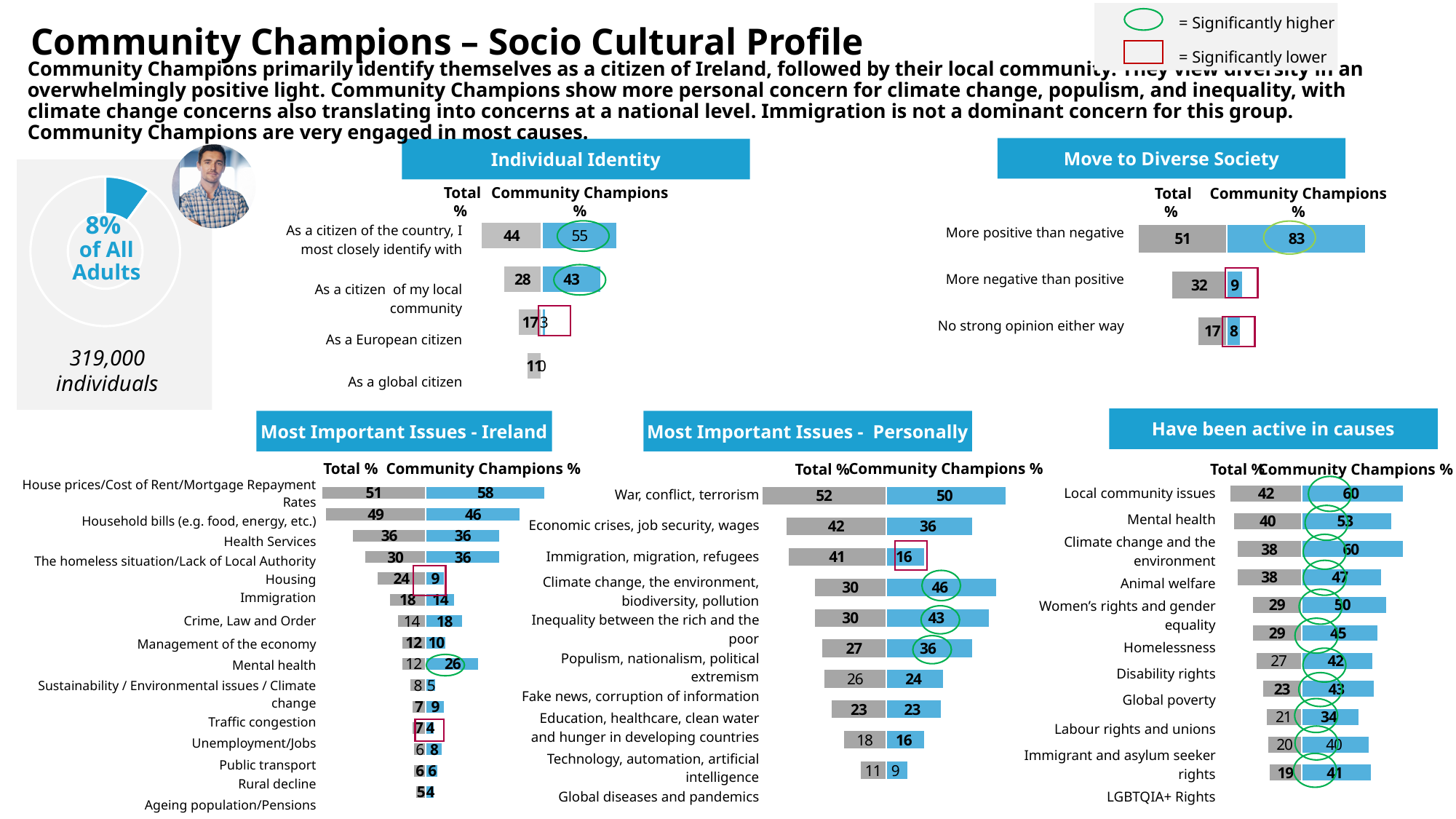
In the Move to Diverse Society chart, what is the Community Champions % for 'More positive than negative'? 83 In the Most Important Issues - Personally chart, which issue has the highest Total %? War, conflict, terrorism In the Most Important Issues - Personally chart, what is the Community Champions % for 'Immigration, migration, refugees'? 16 In the Move to Diverse Society chart, what is the difference between the Total % and the Community Champions % for 'More negative than positive'? 23 In the Individual Identity chart, what is the Total % for 'As a citizen of my local community'? 28 What type of chart is the Move to Diverse Society chart? Bar chart In the Have been active in causes chart, what is the difference between the Community Champions % and the Total % for 'Local community issues'? 18 In the Have been active in causes chart, what is the Community Champions % for 'Animal welfare'? 47 How many causes are listed in the Have been active in causes chart? 11 In the Most Important Issues - Personally chart, which is larger for 'Climate change, the environment, biodiversity, pollution': the Total % or the Community Champions %? Community Champions % In the Move to Diverse Society chart, which response has the highest Community Champions %? More positive than negative In the Individual Identity chart, what is the Community Champions % for 'As a citizen of the country, I most closely identify with'? 55